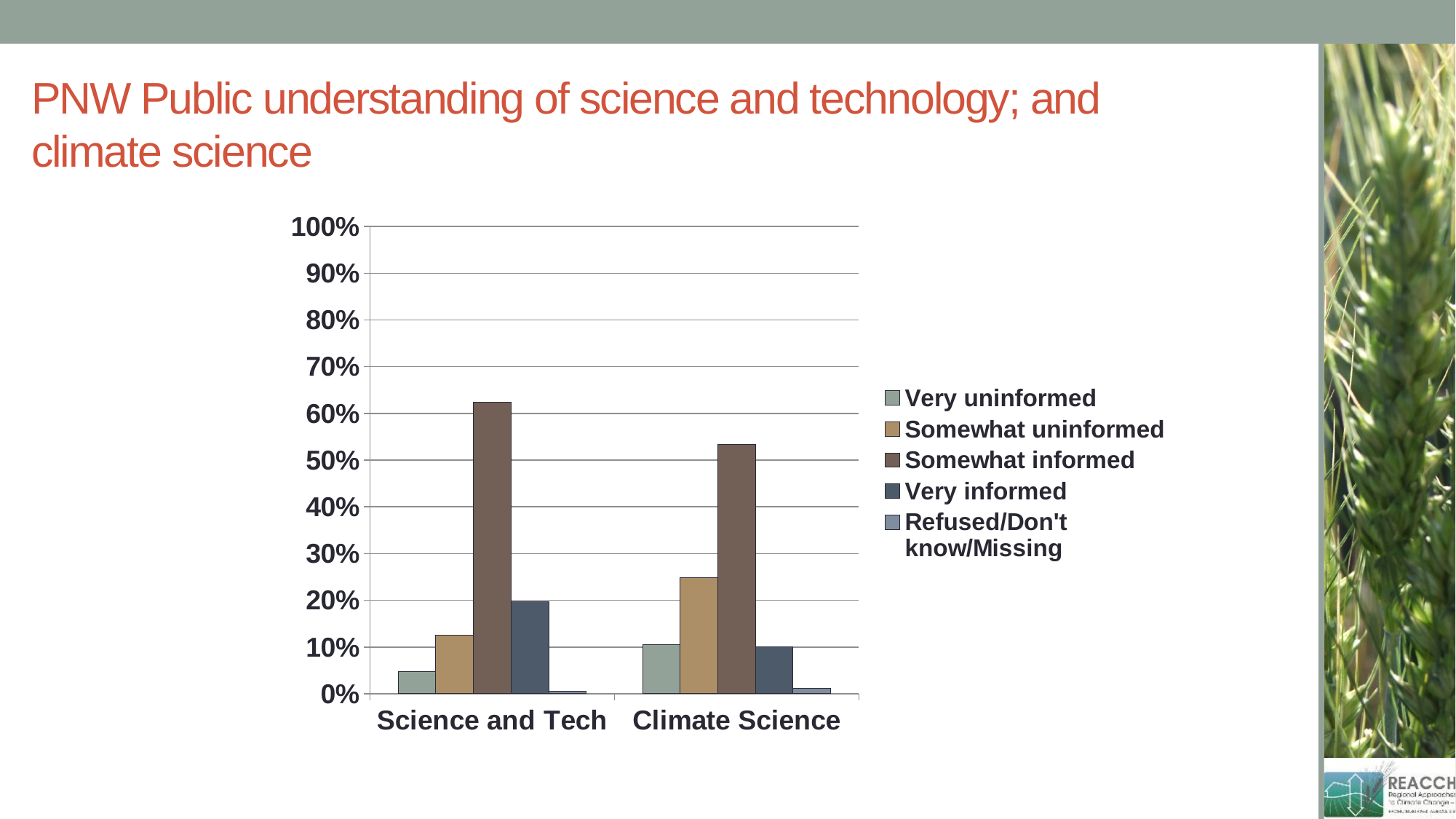
Is the Very uninformed value for Science and Tech greater or less than 10%? less Which category has the larger Somewhat informed value, Science and Tech or Climate Science? Science and Tech What kind of chart is shown on the slide? bar chart Which series has the highest value for Science and Tech? Somewhat informed Which category has the larger Somewhat uninformed value, Science and Tech or Climate Science? Climate Science Is the Somewhat informed value for Science and Tech greater or less than 60%? greater Which category has the larger Very informed value, Science and Tech or Climate Science? Science and Tech How many categories are shown on the x axis? 2 Which series has the lowest value for Climate Science? Refused/Don't know/Missing How many series does the legend list? 5 Is the Somewhat informed value for Climate Science greater or less than 50%? greater